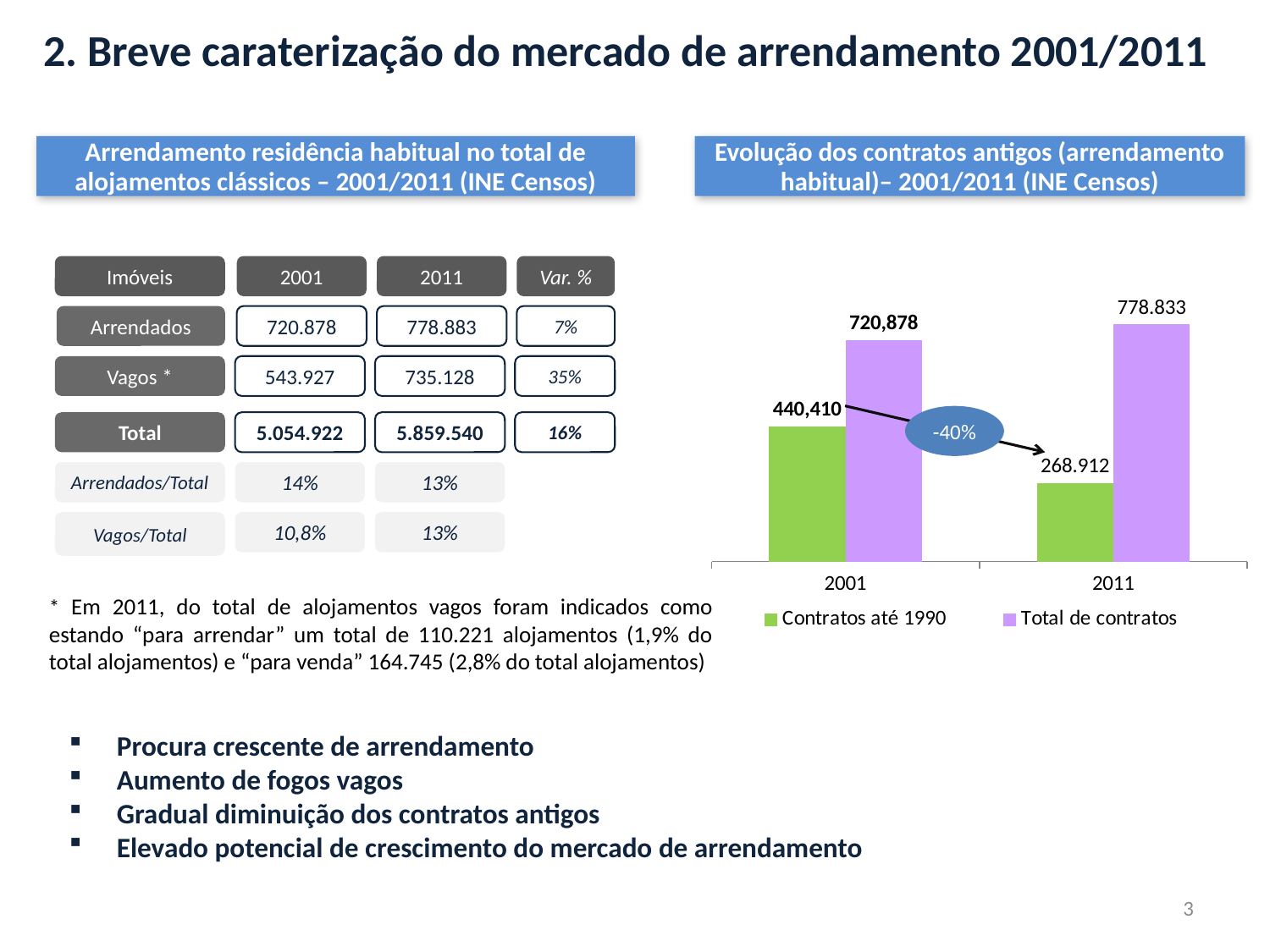
How many years (categories) are shown on the x axis of the 'Evolução dos contratos antigos' chart? 2 In the 'Evolução dos contratos antigos' chart, what is the value of 'Contratos até 1990' for 2001? 440,410 How many series does the legend of the 'Evolução dos contratos antigos' chart list? 2 In the 'Evolução dos contratos antigos' chart, does the 'Contratos até 1990' series rise or fall from 2001 to 2011? fall In the 'Evolução dos contratos antigos' chart, what is the difference between 'Total de contratos' and 'Contratos até 1990' in 2001? 280,468 In the 'Evolução dos contratos antigos' chart, what percentage is shown in the blue oval between the two green bars? -40% In the 'Evolução dos contratos antigos' chart, what is the value of 'Total de contratos' for 2001? 720,878 In the 'Evolução dos contratos antigos' chart, which year has the lower value for 'Contratos até 1990'? 2011 In the 'Evolução dos contratos antigos' chart, what is the value of 'Total de contratos' for 2011? 778.833 In the 'Evolução dos contratos antigos' chart, what is the value of 'Contratos até 1990' for 2011? 268.912 In the 'Evolução dos contratos antigos' chart, does the 'Total de contratos' series rise or fall from 2001 to 2011? rise What kind of chart is shown under the title 'Evolução dos contratos antigos (arrendamento habitual)– 2001/2011 (INE Censos)'? bar chart